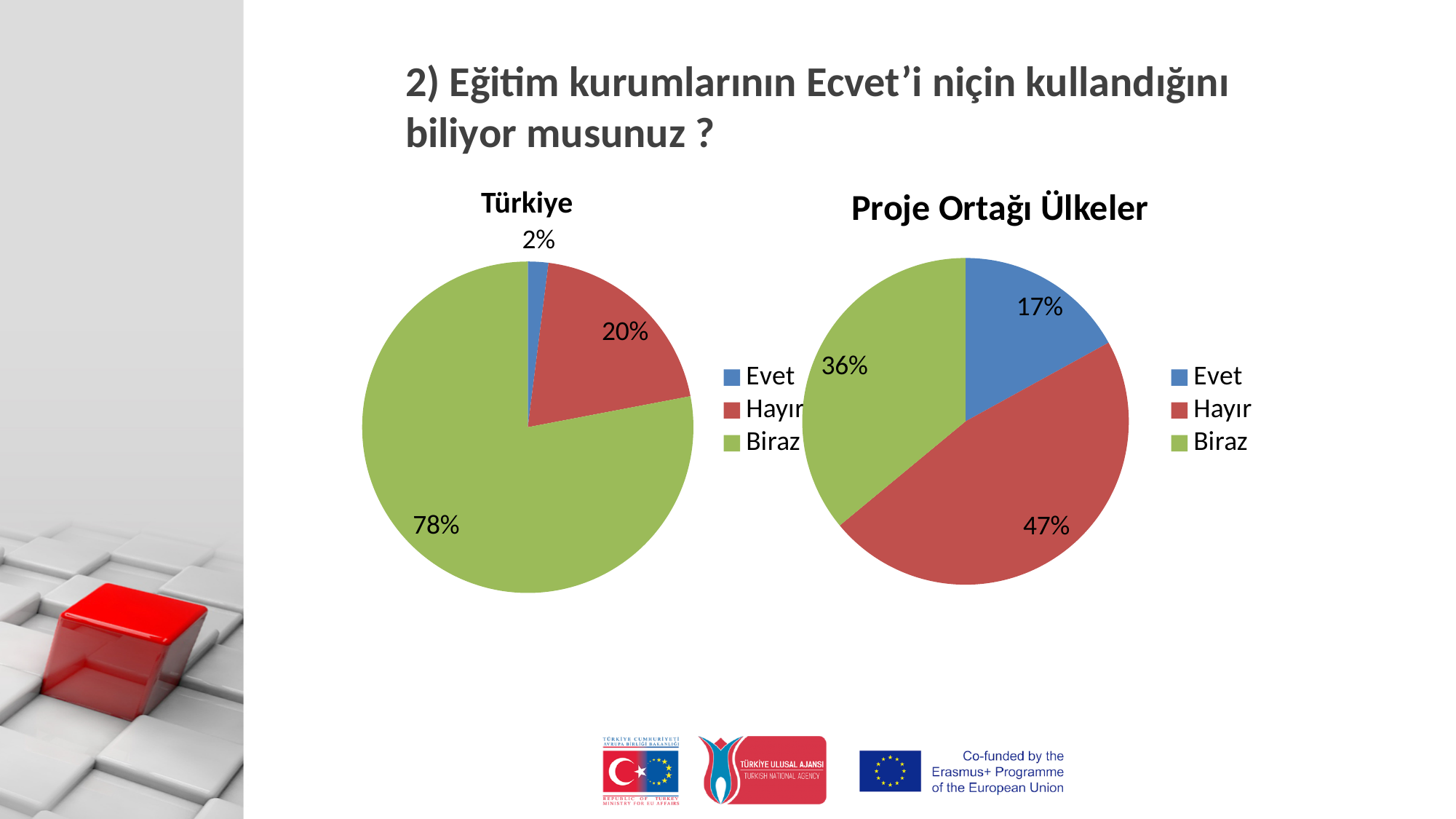
Which is larger: the Hayır share in the Türkiye chart or the Hayır share in the Proje Ortağı Ülkeler chart? Proje Ortağı Ülkeler In the Türkiye pie chart, what share is labelled for Evet? 2% What type of chart is used for Türkiye? Pie chart In the Türkiye pie chart, what share is labelled for Biraz? 78% In the Proje Ortağı Ülkeler pie chart, which category has the smallest slice? Evet In the Proje Ortağı Ülkeler pie chart, what share is labelled for Evet? 17% In the Proje Ortağı Ülkeler pie chart, what share is labelled for Biraz? 36% In the Türkiye pie chart, what share is labelled for Hayır? 20% In the Proje Ortağı Ülkeler pie chart, what share is labelled for Hayır? 47% In the Türkiye pie chart, which category has the largest slice? Biraz How many categories does the legend of the Proje Ortağı Ülkeler chart list? 3 In the Proje Ortağı Ülkeler pie chart, what is the difference in percentage points between Hayır and Biraz? 11